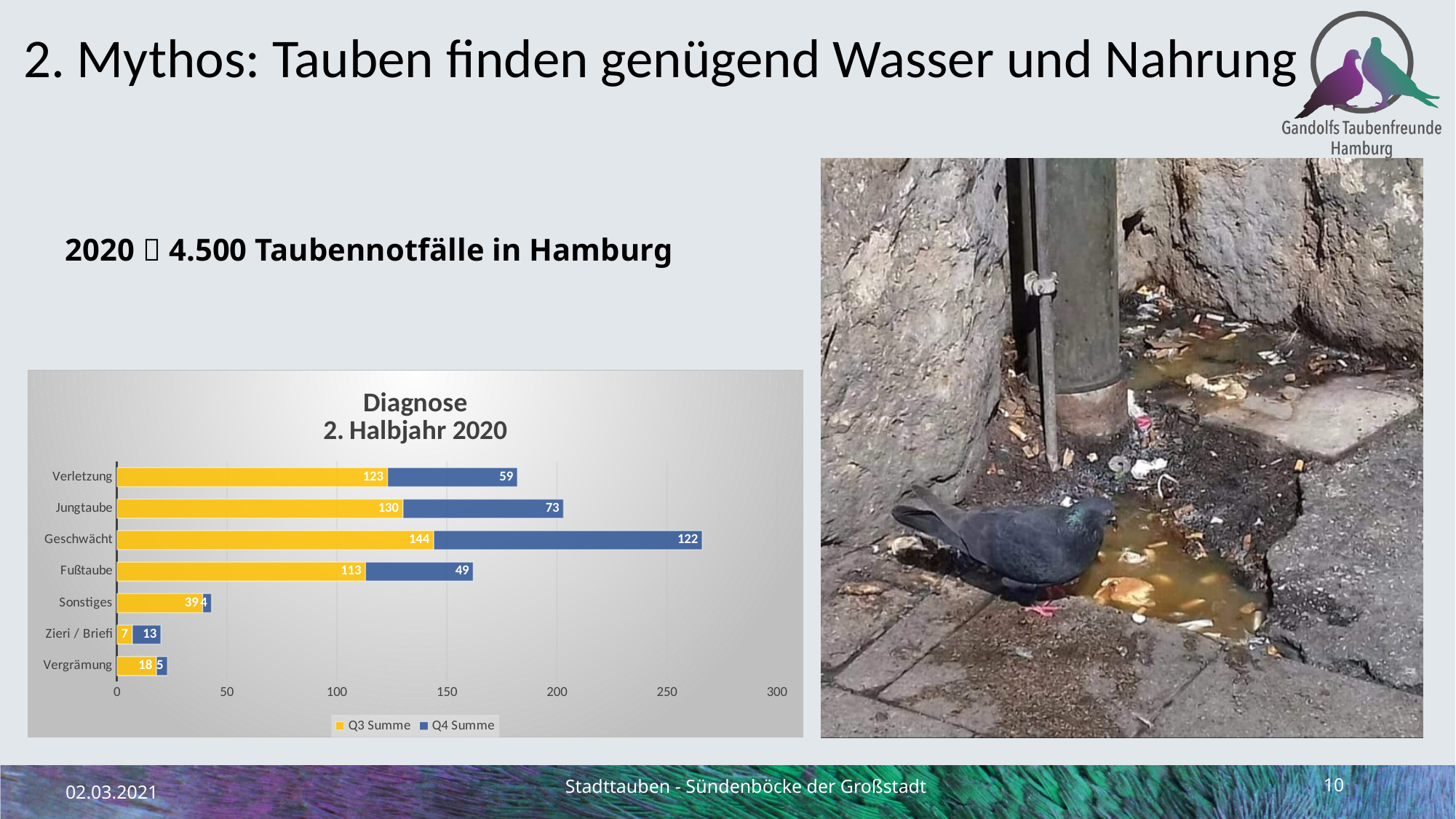
What is the total of the stacked bar for Vergrämung? 23 What is the total of the stacked bar for Geschwächt? 266 How many categories are shown on the chart? 7 Which category has the lowest Q3 Summe value? Zieri / Briefi What is the Q4 Summe value for Fußtaube? 49 How many series does the legend list? 2 What type of chart is shown on the slide? Stacked bar chart What is the Q4 Summe value for Jungtaube? 73 What is the difference between the Q3 Summe and Q4 Summe values for Verletzung? 64 Which category has the highest Q3 Summe value? Geschwächt What is the Q3 Summe value for Geschwächt? 144 Which is larger for Zieri / Briefi, the Q3 Summe or the Q4 Summe value? Q4 Summe